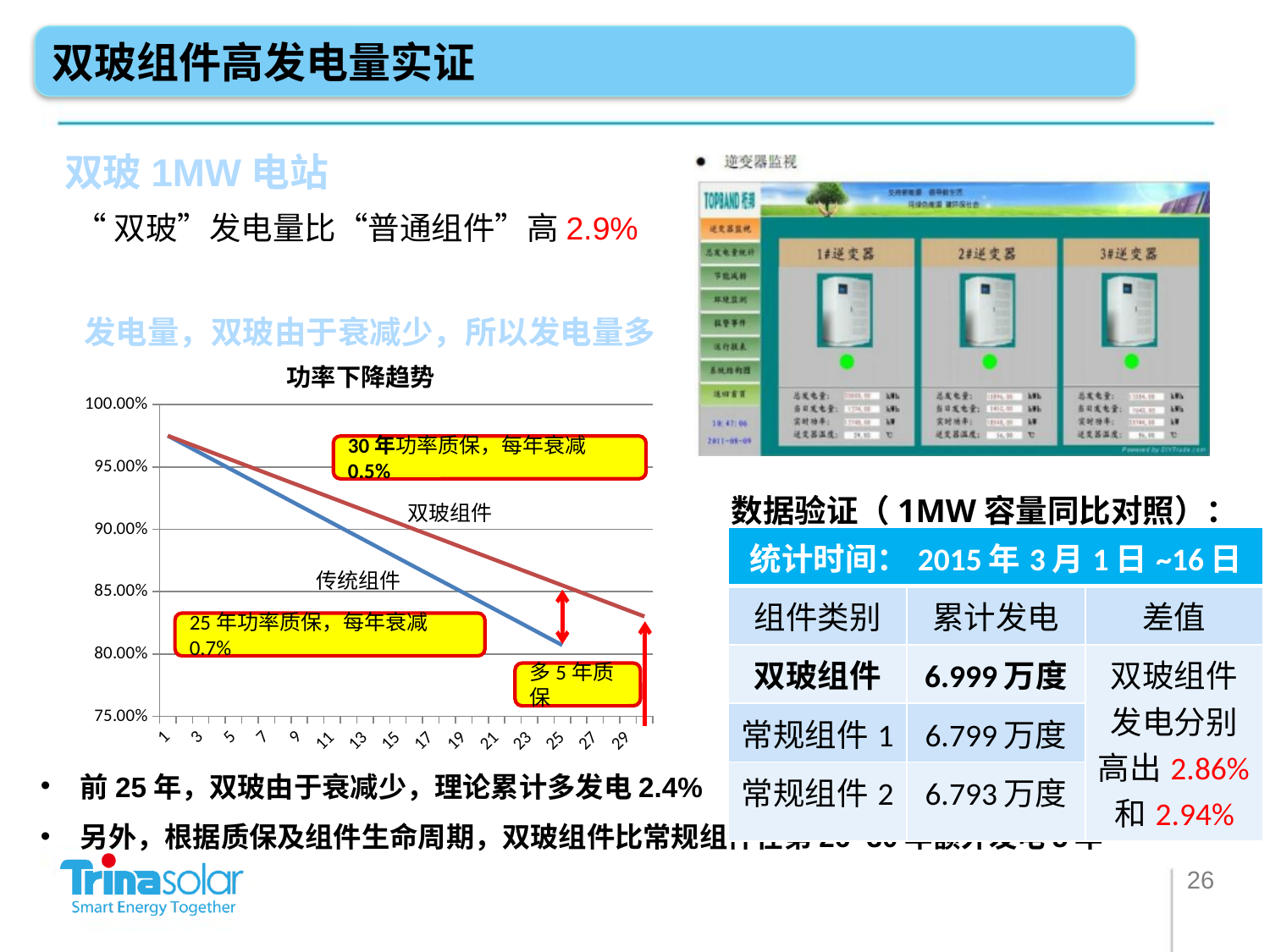
In the "功率下降趋势" chart, which series is higher at year 25, 双玻组件 or 传统组件? 双玻组件 What is the lowest value shown on the y axis of the "功率下降趋势" chart? 75.00% In the "功率下降趋势" chart, is the value for 双玻组件 at year 29 greater or less than 80.00%? greater How many year labels are shown on the x axis of the "功率下降趋势" chart? 15 What is the title of the chart on the left of the slide? 功率下降趋势 What is the highest value shown on the y axis of the "功率下降趋势" chart? 100.00% How many lines (series) are plotted in the "功率下降趋势" chart? 2 In the "功率下降趋势" chart, is the value for 传统组件 at year 25 greater or less than 85.00%? less In the "功率下降趋势" chart, which series is lower at year 25? 传统组件 What kind of chart is the "功率下降趋势" chart? line chart In the "功率下降趋势" chart, do the values rise or fall as the year increases along the x axis? fall In the "功率下降趋势" chart, is the starting value of 双玻组件 at year 1 greater or less than 95.00%? greater